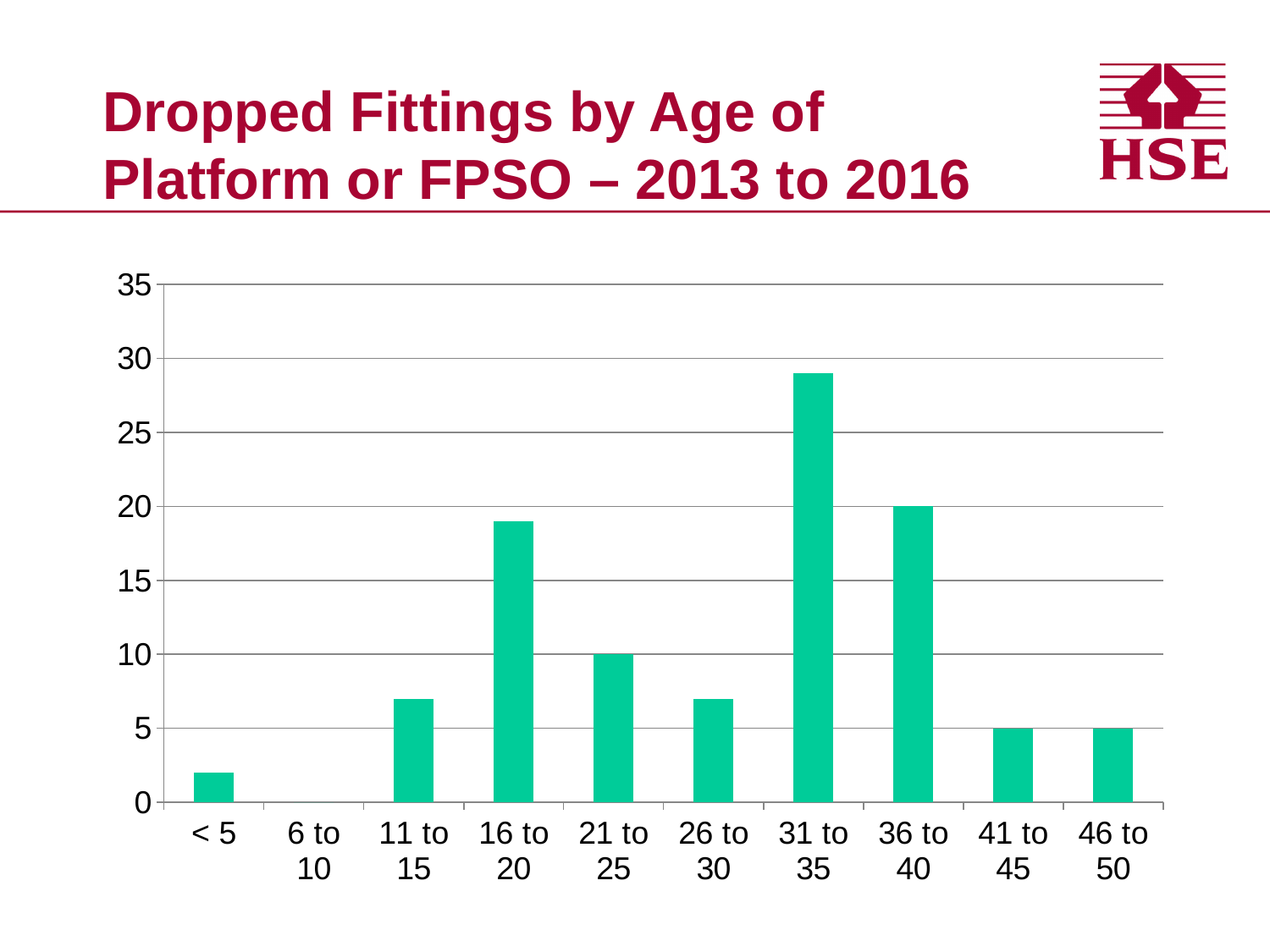
What is the title of the slide containing the chart? Dropped Fittings by Age of Platform or FPSO – 2013 to 2016 Is the value for 31 to 35 greater or less than 30? less Which is larger, the value for 16 to 20 or the value for 26 to 30? 16 to 20 What type of chart is shown on the slide? bar chart Which age group has the lowest number of dropped fittings? 6 to 10 What is the difference between the values for 36 to 40 and 21 to 25? 10 Is the value for 16 to 20 greater or less than 15? greater What is the value for the 21 to 25 age group? 10 Which age group has the highest number of dropped fittings? 31 to 35 What is the value for the 41 to 45 age group? 5 How many age categories are shown on the x axis? 10 What is the value for the 36 to 40 age group? 20